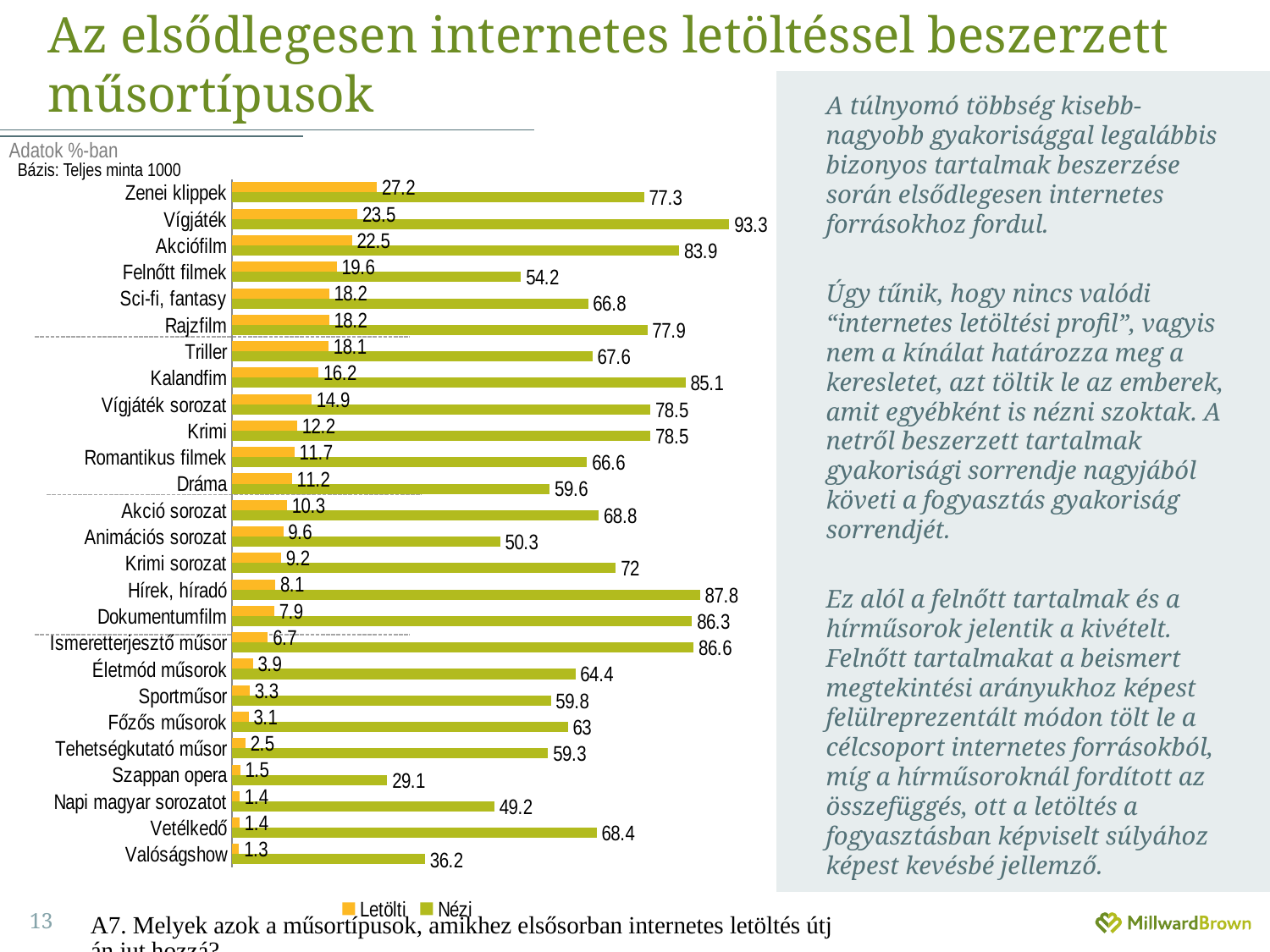
What is the difference between the Nézi and Letölti values for Akciófilm? 61.4 What is the Letölti value for Zenei klippek? 27.2 Which is larger, the Nézi value for Felnőtt filmek or the Nézi value for Rajzfilm? Rajzfilm Which category has the lowest Nézi value? Szappan opera Which category has the lowest Letölti value? Valóságshow Which category has the highest Nézi value? Vígjáték What are the two series named in the legend? Letölti and Nézi How many series does the legend list? 2 What is the Nézi value for Hírek, híradó? 87.8 What is the Nézi value for Vígjáték? 93.3 How many categories are shown in the chart? 26 What kind of chart is shown on the slide? Bar chart